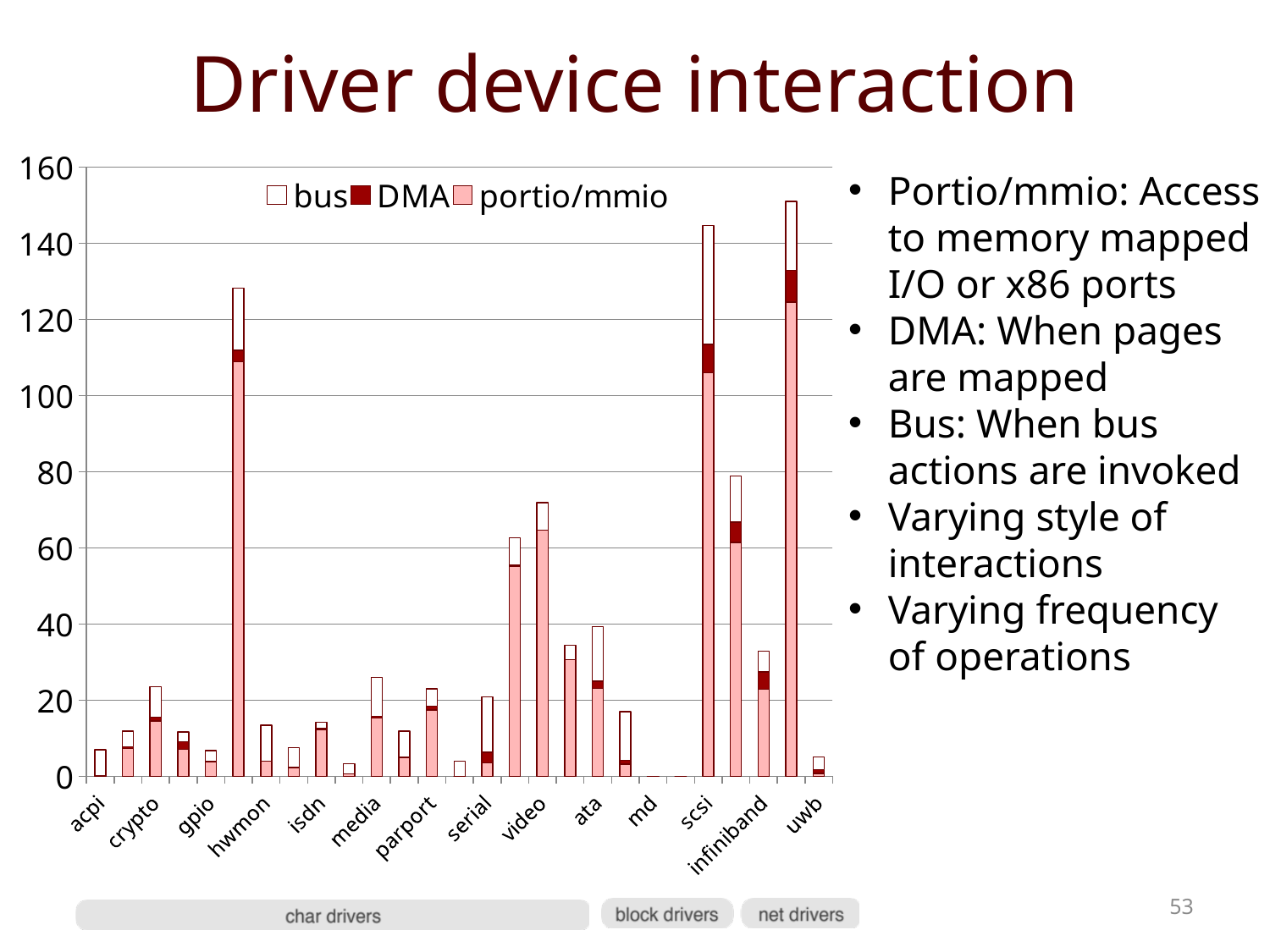
Which has the larger total, scsi or md? scsi Is the total value for uwb greater or less than 20? less Is the total value for video greater or less than 60? greater How many category labels are shown along the x axis? 14 Is the total value for scsi greater or less than 100? greater How many series does the legend list? 3 What are the three series named in the legend? bus, DMA, portio/mmio Which series is drawn in dark red? DMA What kind of chart is shown on the slide? stacked bar chart Which has the larger total, video or acpi? video